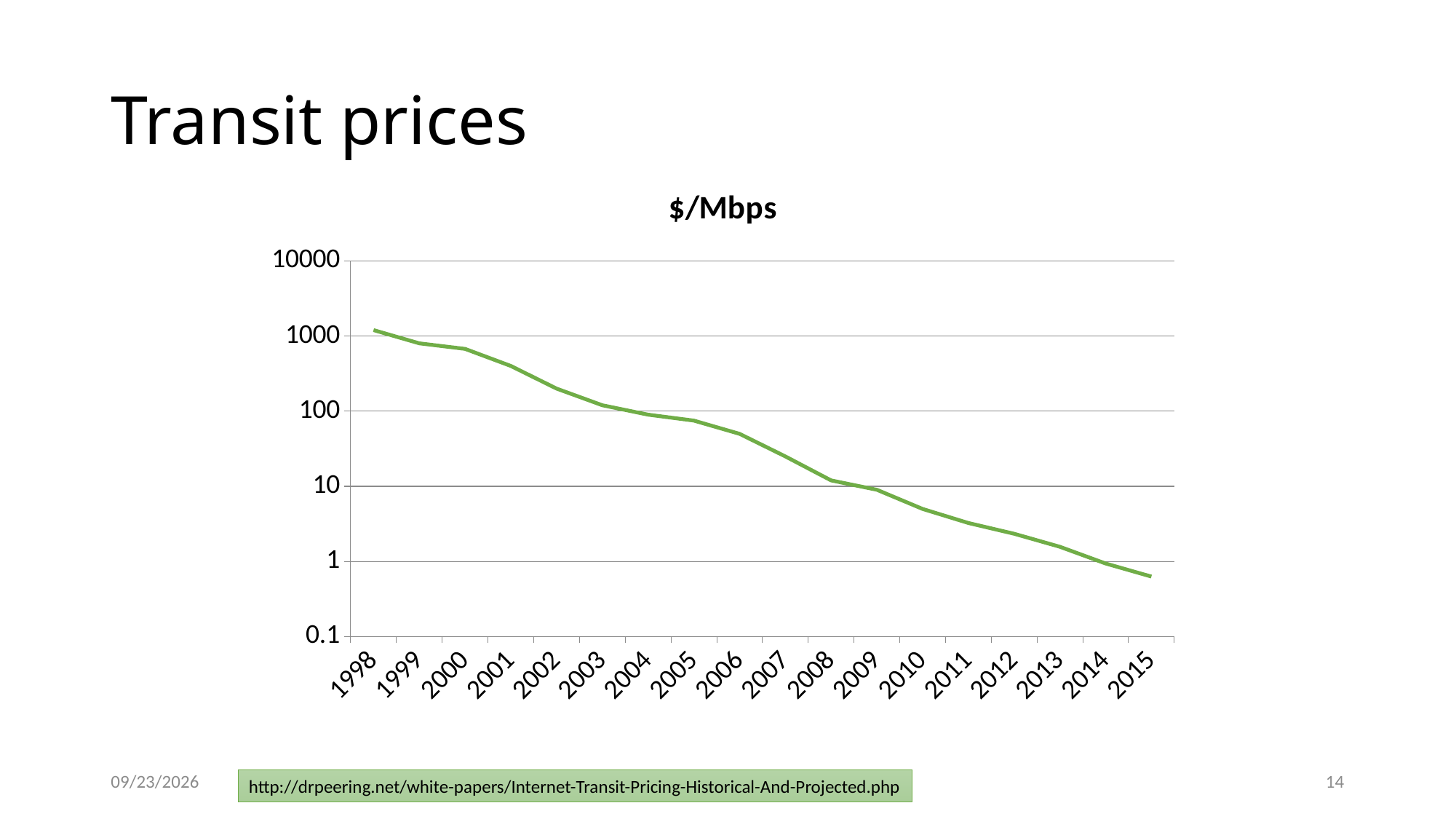
Do the $/Mbps values rise or fall from 1998 to 2015? fall Is the value for 2010 greater or less than 10? less What kind of chart is shown on the slide? line chart Is the value for 2005 greater or less than 100? less Which year has the lowest $/Mbps value? 2015 Which year has the larger $/Mbps value, 2001 or 2011? 2001 How many years are plotted along the x axis? 18 Is the value for 2015 greater or less than 1? less Which year has the highest $/Mbps value? 1998 What is the title of the chart? $/Mbps